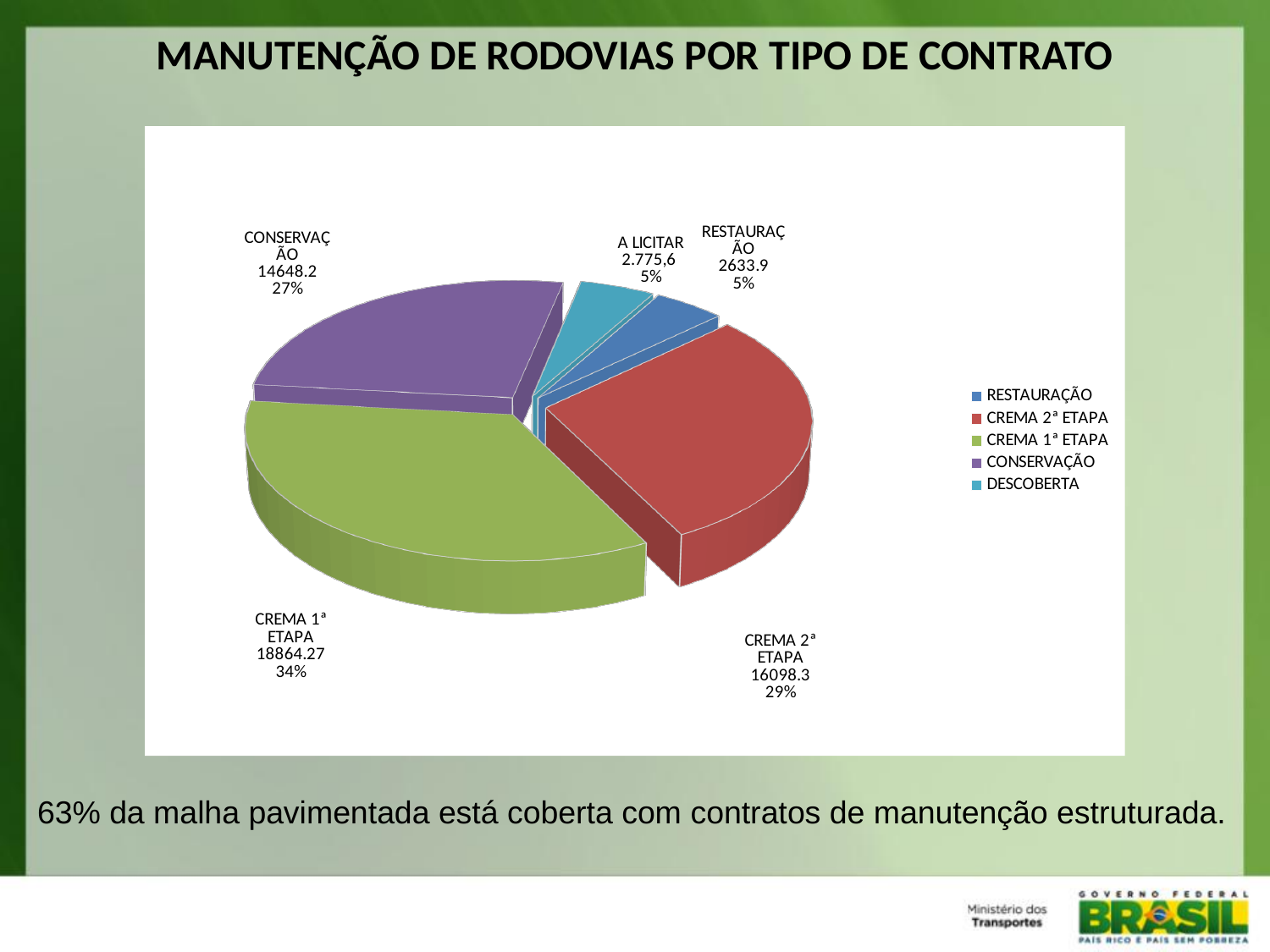
What value is shown for RESTAURAÇÃO? 2633.9 Which category has the smallest value according to the data labels? RESTAURAÇÃO How many slices does the pie chart have? 5 What kind of chart is shown on the slide? pie chart How many entries does the legend list? 5 Which is larger, the value for CONSERVAÇÃO or the value for CREMA 2ª ETAPA? CREMA 2ª ETAPA Which category has the largest slice of the pie? CREMA 1ª ETAPA What share of the pie does CONSERVAÇÃO represent? 27% What value is shown for CONSERVAÇÃO? 14648.2 What value is shown for CREMA 1ª ETAPA? 18864.27 What share of the pie does CREMA 2ª ETAPA represent? 29% What is the difference between the values for CREMA 1ª ETAPA and CREMA 2ª ETAPA? 2765.97